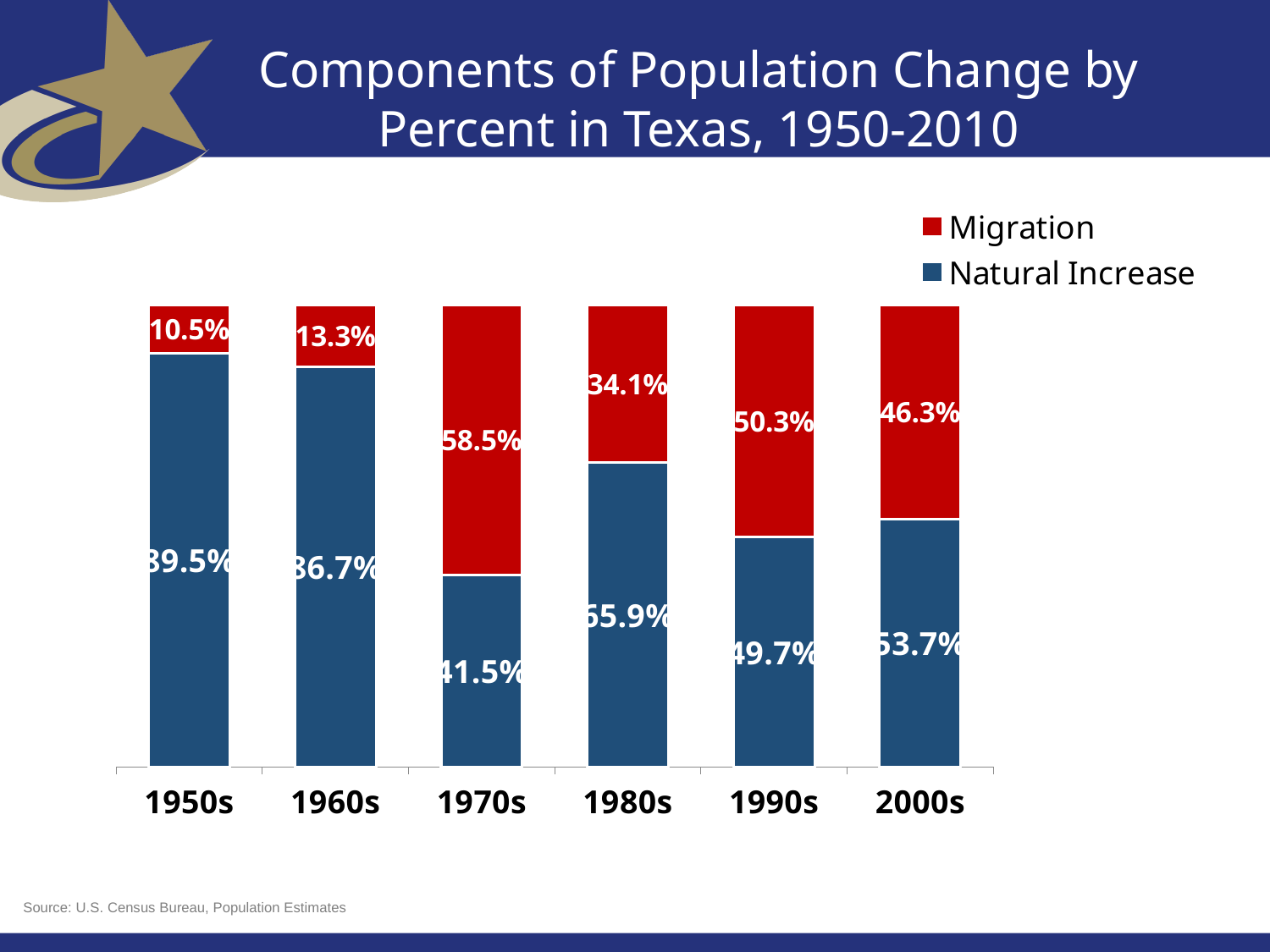
What is the Migration share for the 1970s? 58.5% Which decade has the larger Migration share, the 1950s or the 1960s? 1960s What kind of chart is shown on the slide? Stacked bar chart What is the Natural Increase share for the 1990s? 49.7% Which decade has the highest Migration share? 1970s Which decade has the lowest Migration share? 1950s How many decades are shown on the x axis? 6 How many series does the legend list? 2 What is the Migration share for the 2000s? 46.3% Does the Migration share rise or fall from the 1950s to the 1970s? Rises How much larger is the Migration share in the 1990s than in the 1980s? 16.2 percentage points What is the Natural Increase share for the 1970s? 41.5%